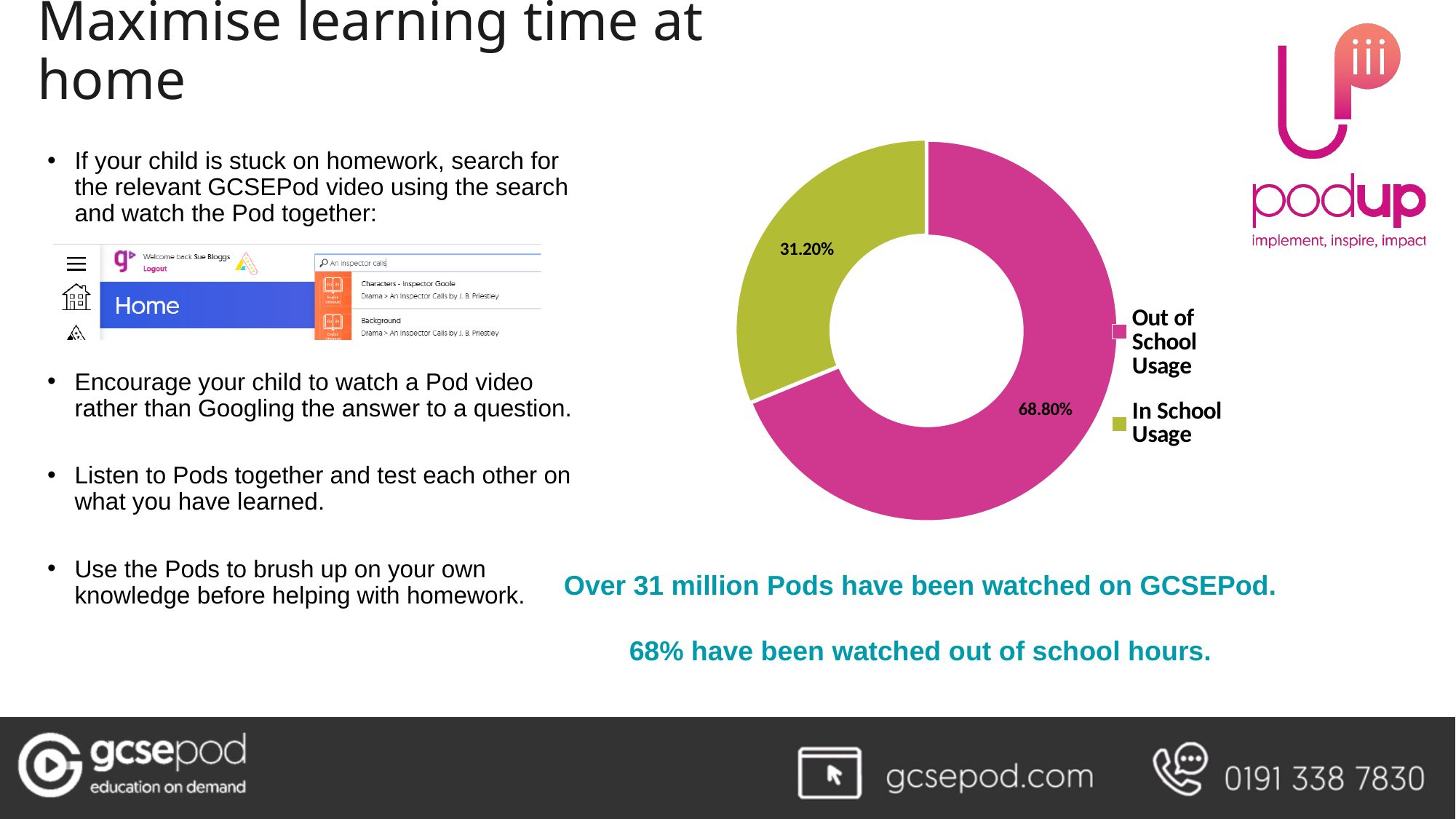
Which category has the smallest share of the chart? In School Usage What colour is the In School Usage slice? Green (olive) What is the total of the two slices shown in the chart? 100.00% How many categories does the chart show? 2 What percentage of usage is In School Usage? 31.20% What kind of chart is shown on the slide? Pie chart (doughnut) What colour is the Out of School Usage slice? Pink (magenta) What is the difference between the Out of School Usage and In School Usage percentages? 37.60% How many entries does the legend list? 2 Which category has the largest share of the chart? Out of School Usage What percentage of usage is Out of School Usage? 68.80% Which is larger, Out of School Usage or In School Usage? Out of School Usage